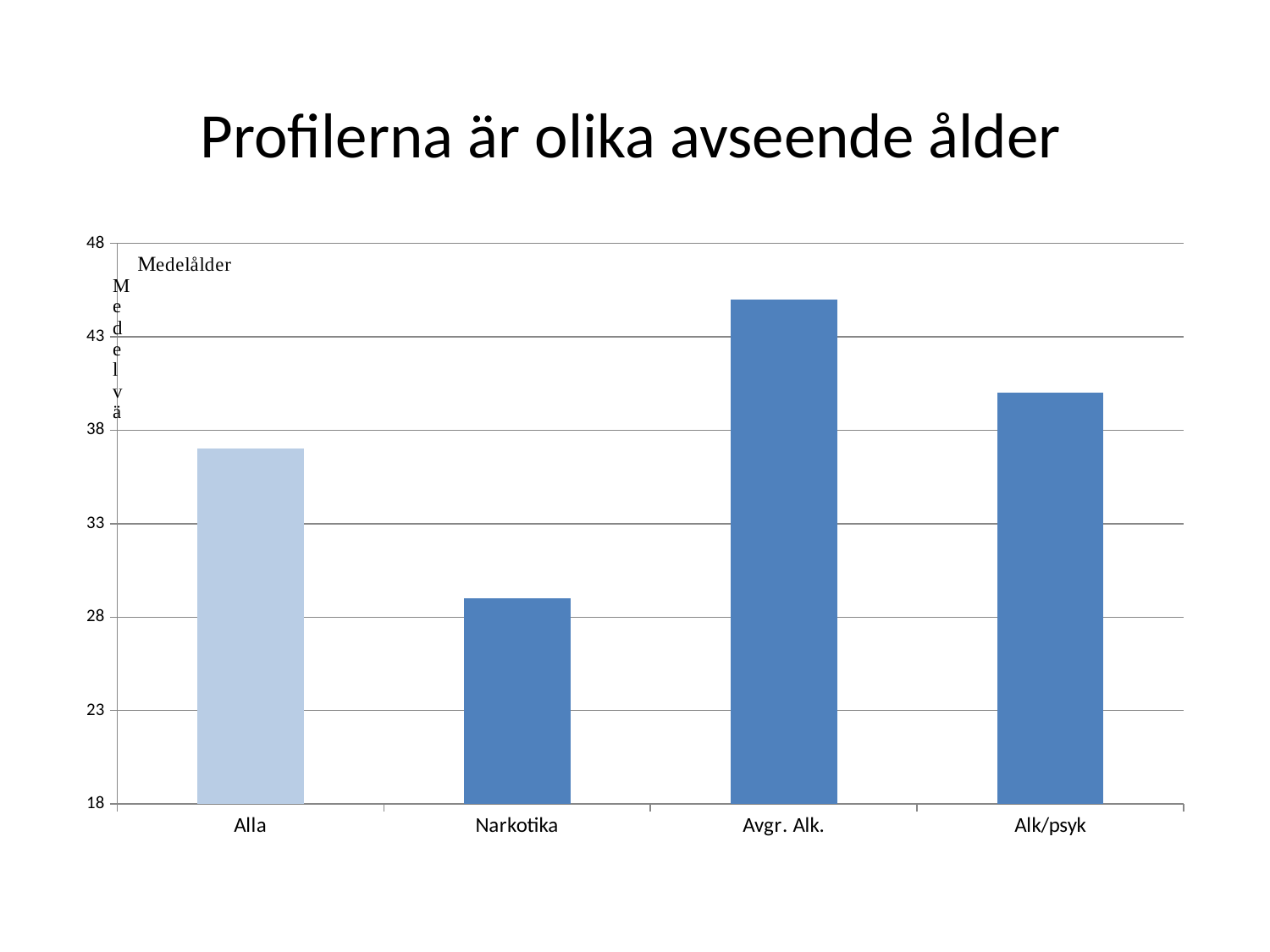
What kind of chart is shown on the slide? bar chart Is the value for Alla greater or less than 33? greater What is the title of the slide containing the chart? Profilerna är olika avseende ålder How many categories are shown on the x axis of the chart? 4 Is the value for Avgr. Alk. greater or less than 43? greater Is the value for Alk/psyk greater or less than 43? less Which category has the highest value in the chart? Avgr. Alk. Which is larger, the value for Narkotika or the value for Avgr. Alk.? Avgr. Alk. Which category has the lowest value in the chart? Narkotika Which is larger, the value for Alla or the value for Alk/psyk? Alk/psyk